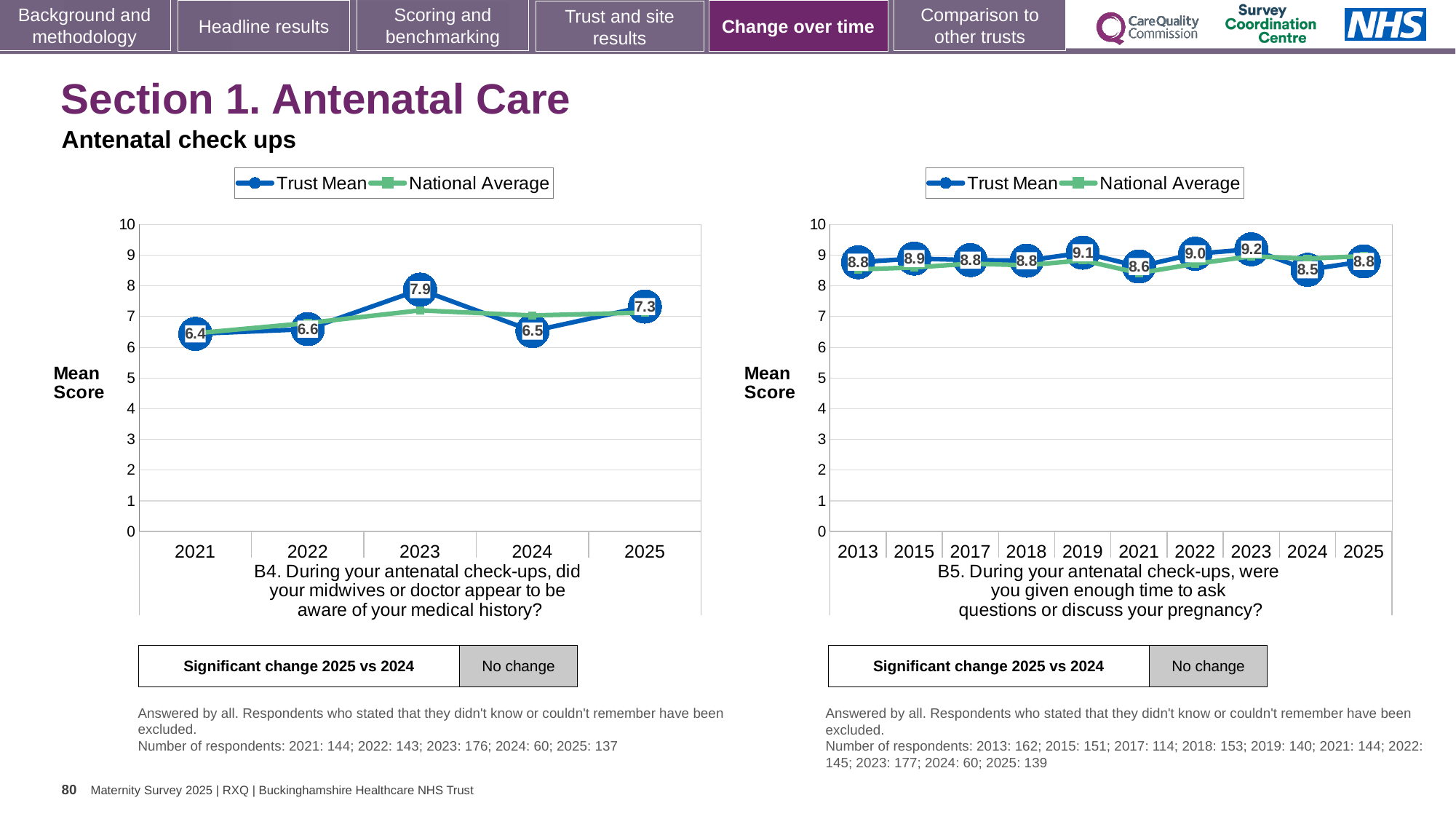
In the right chart (B5), what is the Trust Mean for 2024? 8.5 In the left chart (B4), what is the Trust Mean for 2023? 7.9 In the left chart (B4), which year has the lowest Trust Mean? 2021 In the right chart (B5), is the Trust Mean for 2019 larger or smaller than for 2021? larger In the left chart (B4), how many years are shown on the x axis? 5 In the left chart (B4), which year has the highest Trust Mean? 2023 In the right chart (B5), which year has the lowest Trust Mean? 2024 In the left chart (B4), what is the Trust Mean for 2021? 6.4 How many series does the legend of the right chart (B5) list? 2 In the right chart (B5), how many years are shown on the x axis? 10 In the right chart (B5), what is the Trust Mean for 2023? 9.2 In the left chart (B4), what is the difference between the Trust Mean in 2023 and in 2024? 1.4